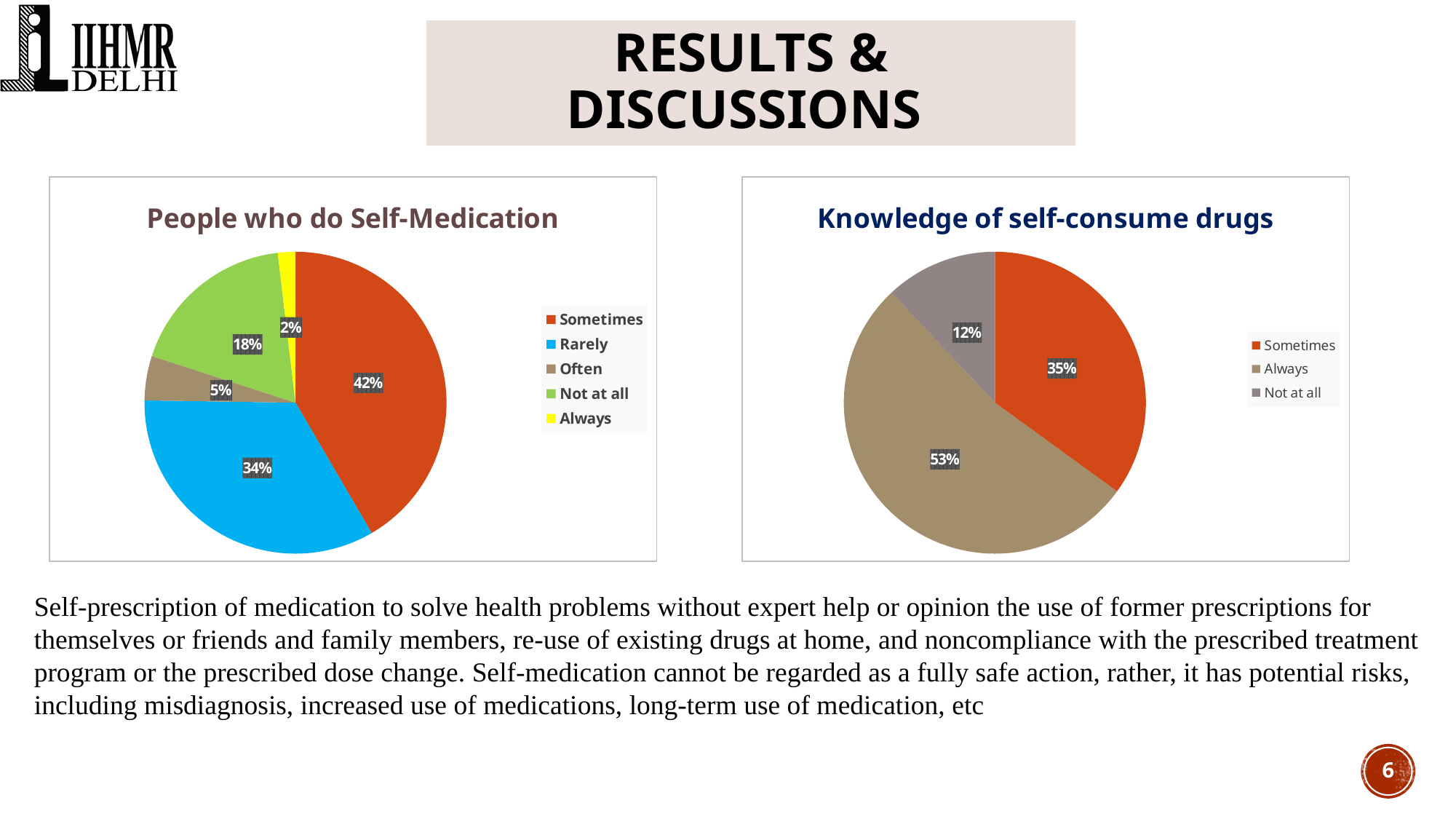
How many entries does the legend of the 'Knowledge of self-consume drugs' chart list? 3 In the 'People who do Self-Medication' chart, what is the difference in percentage points between Not at all and Often? 13 In the 'People who do Self-Medication' chart, what percentage is shown for Sometimes? 42% In the 'People who do Self-Medication' chart, what colour is the Rarely slice? Blue In the 'People who do Self-Medication' chart, what percentage is shown for Rarely? 34% In the 'Knowledge of self-consume drugs' chart, which is larger: Sometimes or Always? Always In the 'Knowledge of self-consume drugs' chart, what percentage is shown for Always? 53% In the 'People who do Self-Medication' chart, which category has the smallest share? Always What type of chart is 'Knowledge of self-consume drugs'? Pie chart In the 'People who do Self-Medication' chart, which category has the largest share? Sometimes How many categories does the 'People who do Self-Medication' chart show? 5 In the 'Knowledge of self-consume drugs' chart, what percentage is shown for Not at all? 12%